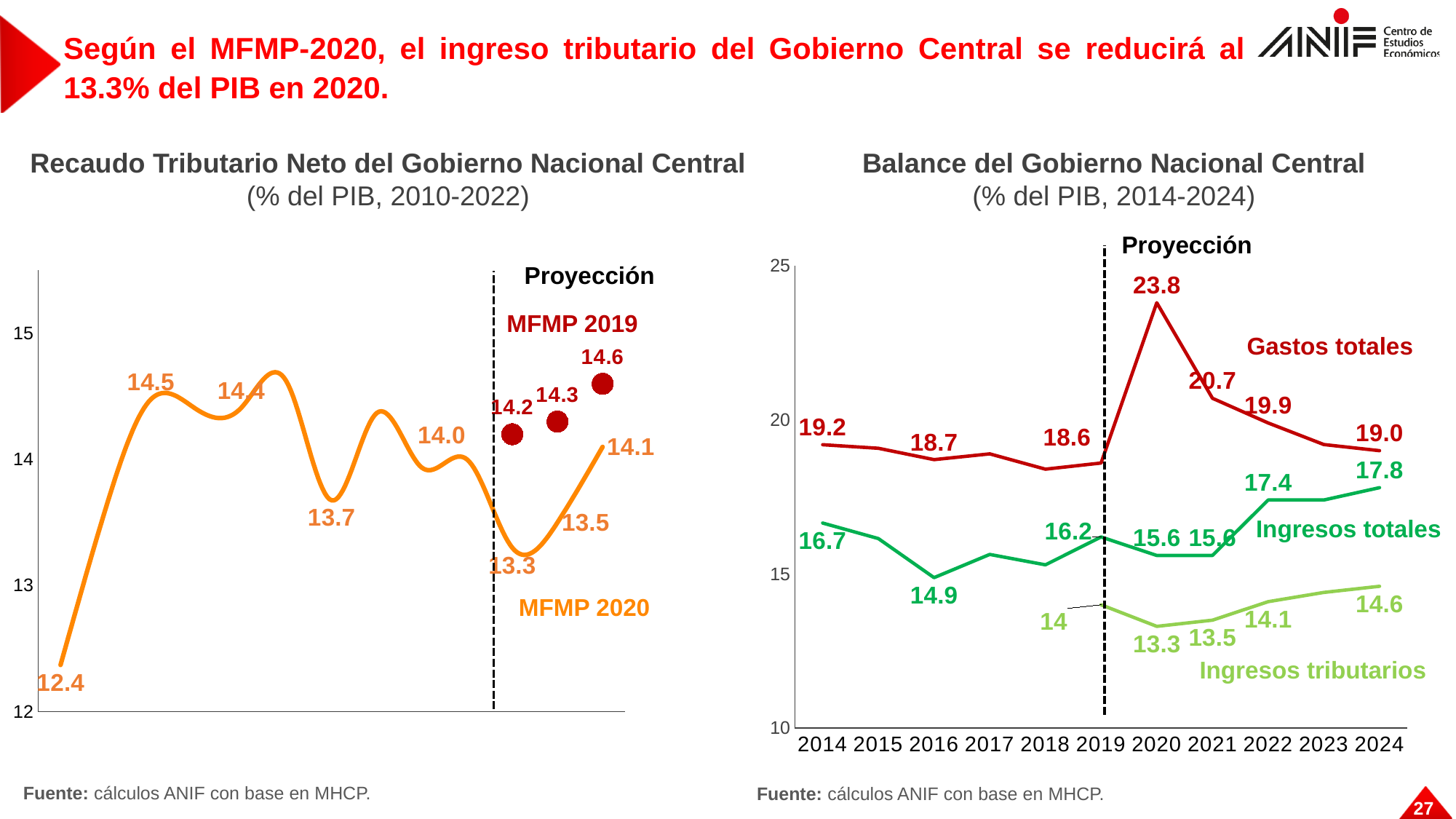
In the 'Balance del Gobierno Nacional Central' chart, is the value of Ingresos totales in 2015 greater or less than 15? greater In the 'Balance del Gobierno Nacional Central' chart, what is the value of Gastos totales in 2020? 23.8 In the 'Balance del Gobierno Nacional Central' chart, what is the value of Ingresos totales in 2024? 17.8 In the 'Balance del Gobierno Nacional Central' chart, what is the value of Ingresos tributarios in 2020? 13.3 In the 'Balance del Gobierno Nacional Central' chart, in which year do Ingresos totales reach their lowest value? 2016 In the 'Balance del Gobierno Nacional Central' chart, what is the difference between Gastos totales and Ingresos totales in 2020? 8.2 In the 'Balance del Gobierno Nacional Central' chart, in which year do Gastos totales reach their highest value? 2020 What type of chart is the 'Recaudo Tributario Neto del Gobierno Nacional Central' chart? line chart How many series are plotted in the 'Balance del Gobierno Nacional Central' chart? 3 In the 'Balance del Gobierno Nacional Central' chart, by how much do Gastos totales fall from 2020 to 2021? 3.1 In the 'Recaudo Tributario Neto del Gobierno Nacional Central' chart, what is the lowest value of the MFMP 2020 projection? 13.3 In the 'Recaudo Tributario Neto del Gobierno Nacional Central' chart, what is the highest value of the MFMP 2019 projection? 14.6